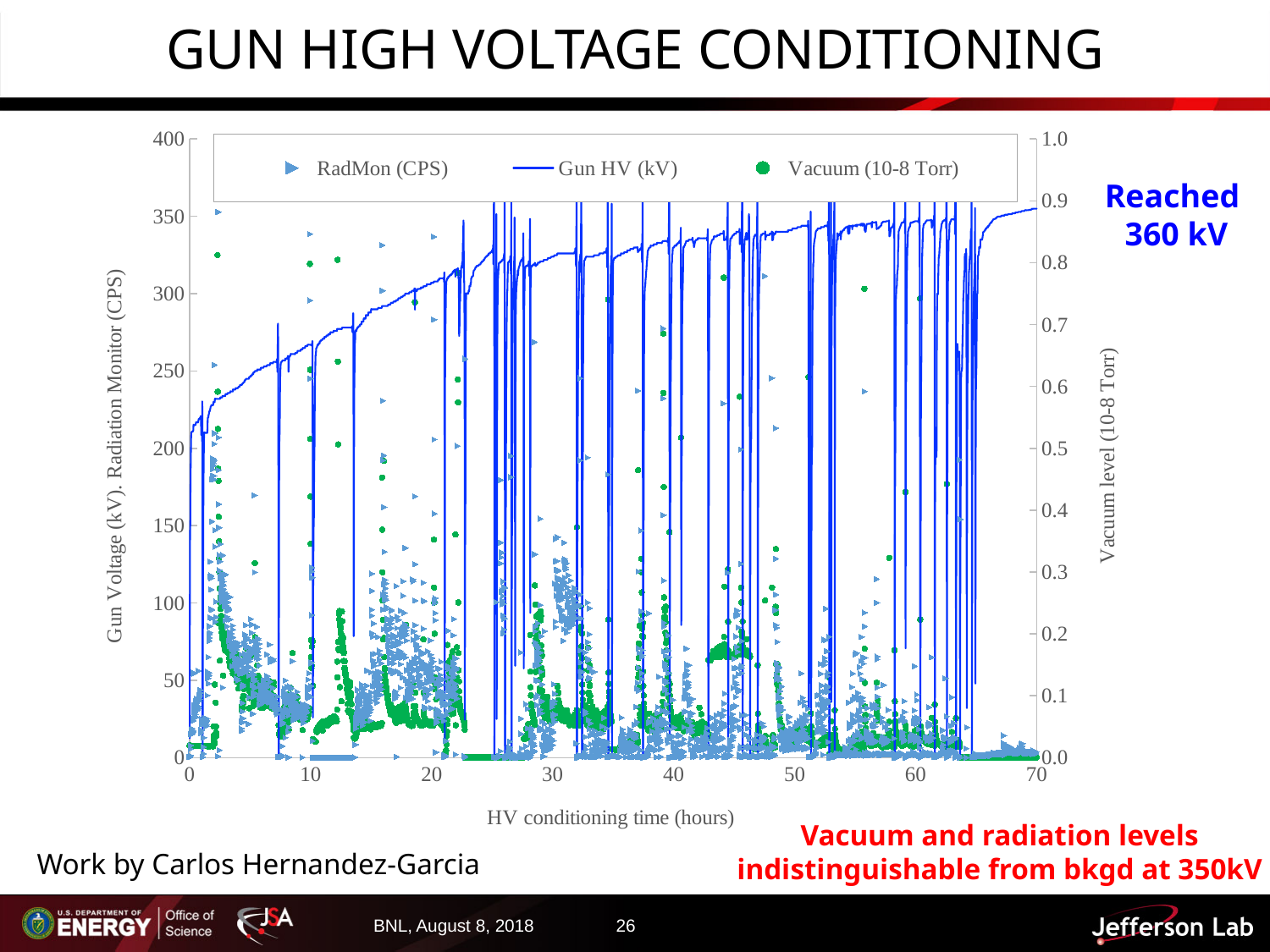
According to the slide text, what gun voltage was reached? 360 kV Does the Gun HV (kV) line generally rise or fall as HV conditioning time increases? rise What is the maximum value shown on the right-hand vacuum level axis? 1.0 Is the Gun HV (kV) value at 70 hours greater or less than 300? greater What are the three series named in the chart legend? RadMon (CPS), Gun HV (kV), Vacuum (10-8 Torr) What is the label of the x axis of the chart? HV conditioning time (hours) Is the Gun HV (kV) value at 0 hours greater or less than 250? less Which series is drawn as a continuous line rather than as scattered markers? Gun HV (kV) How many series does the chart legend list? 3 What is the maximum HV conditioning time shown on the x axis? 70 What is the maximum value shown on the left-hand axis of the chart? 400